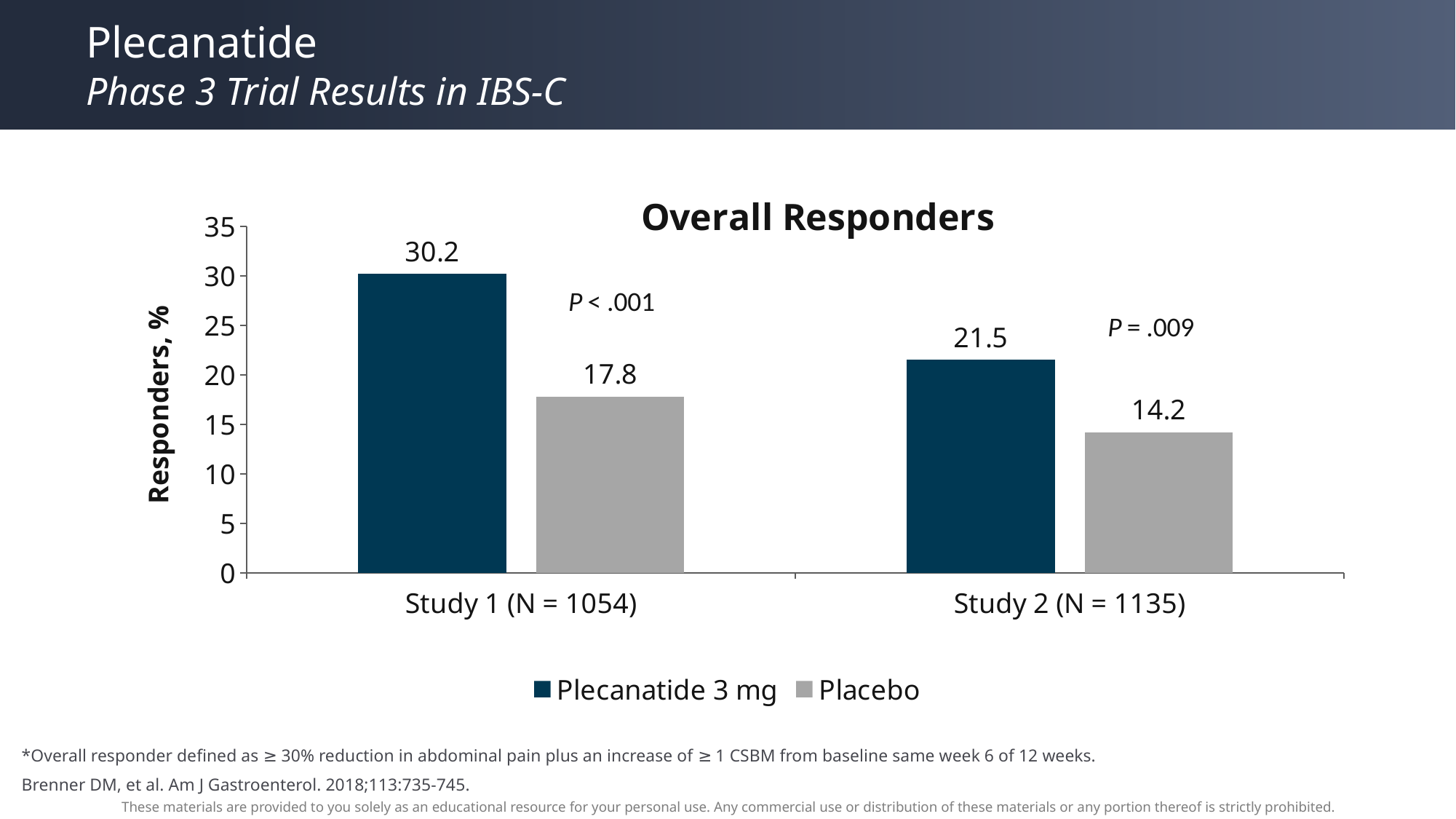
What kind of chart is shown on the slide? Bar chart What is the value for Placebo in Study 2 (N = 1135)? 14.2 What is the difference between Plecanatide 3 mg and Placebo in Study 1 (N = 1054)? 12.4 Which bar has the lowest value on the chart? Placebo, Study 2 (N = 1135) Which bar has the highest value on the chart? Plecanatide 3 mg, Study 1 (N = 1054) How many series does the legend list? 2 How many study categories are shown on the x axis? 2 What is the title of the chart? Overall Responders What is the value for Placebo in Study 1 (N = 1054)? 17.8 What is the difference between Plecanatide 3 mg and Placebo in Study 2 (N = 1135)? 7.3 Which is larger: Plecanatide 3 mg in Study 2 (N = 1135) or Placebo in Study 1 (N = 1054)? Plecanatide 3 mg in Study 2 (N = 1135) What is the value for Plecanatide 3 mg in Study 1 (N = 1054)? 30.2